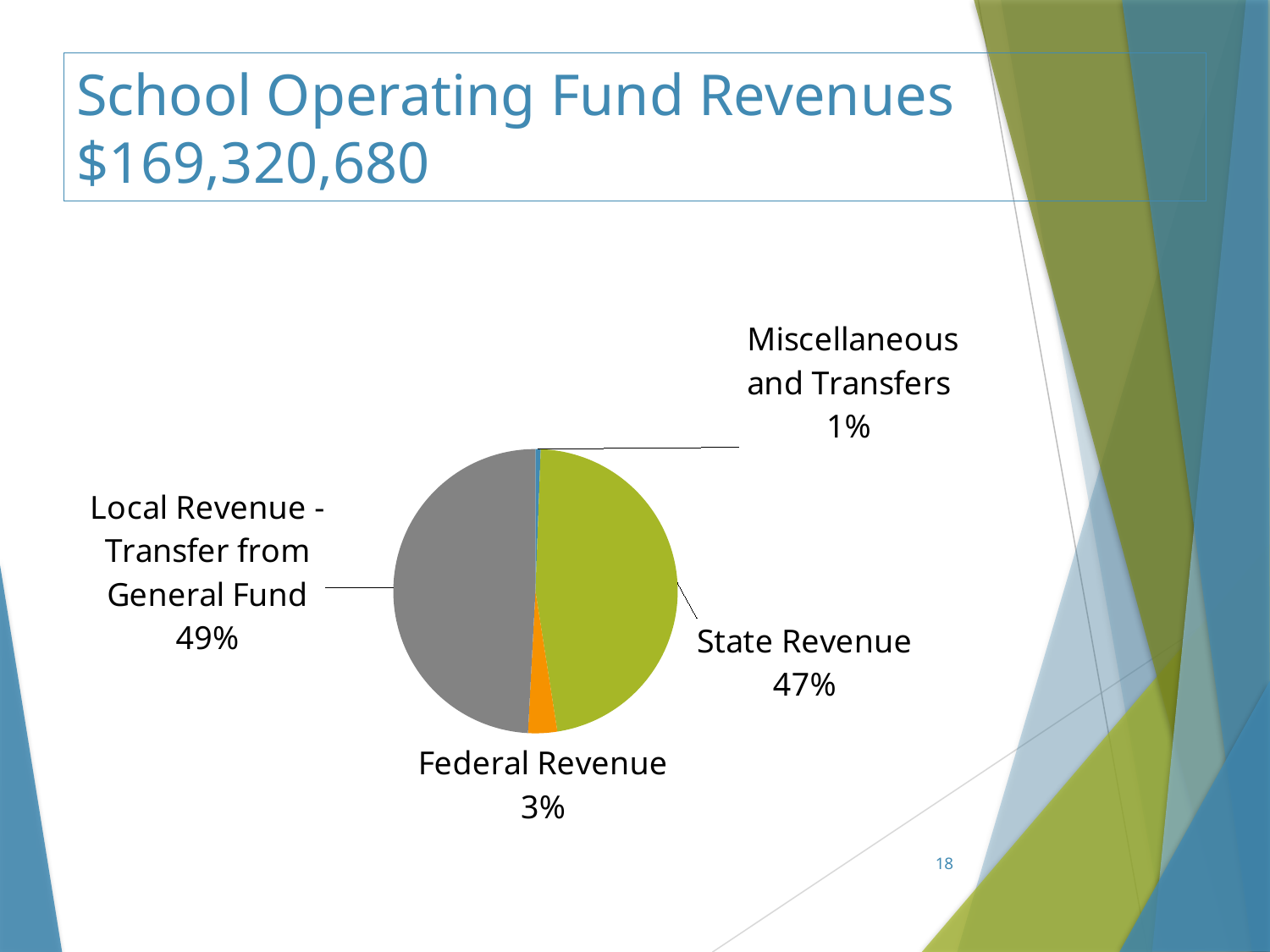
Which is larger, Federal Revenue or Miscellaneous and Transfers? Federal Revenue What colour is the State Revenue slice? green What share of School Operating Fund Revenues comes from State Revenue? 47% What is the difference in percentage points between Local Revenue - Transfer from General Fund and State Revenue? 2 What percentage is shown for Federal Revenue? 3% What share of the pie is Local Revenue - Transfer from General Fund? 49% What kind of chart is shown on the slide? pie chart Which category has the largest share of the pie? Local Revenue - Transfer from General Fund What total dollar amount is given in the slide title for School Operating Fund Revenues? $169,320,680 How many slices does the pie chart have? 4 What percentage is shown for Miscellaneous and Transfers? 1% Which category has the smallest share of the pie? Miscellaneous and Transfers